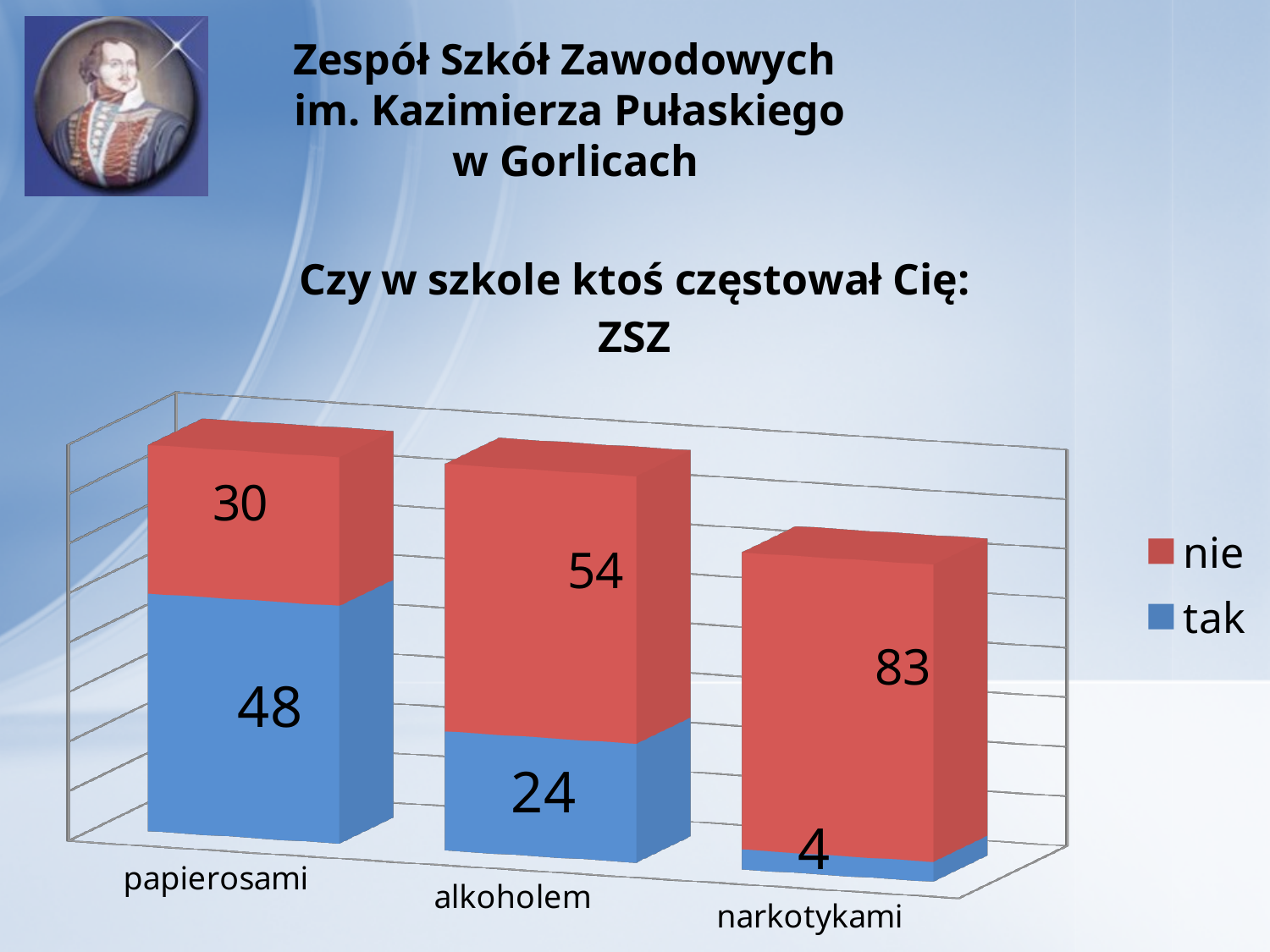
What kind of chart is shown on the slide? stacked bar chart How many series does the legend list? 2 Which is larger: the "tak" value for alkoholem or the "nie" value for alkoholem? nie Which category has the highest "tak" value? papierosami What is the value for "tak" for narkotykami? 4 What is the value for "nie" for alkoholem? 54 What is the value for "nie" for narkotykami? 83 Which category has the lowest "nie" value? papierosami What is the total of the stacked bar for papierosami? 78 How many categories are shown on the x axis? 3 What is the difference between the "nie" value for narkotykami and the "nie" value for alkoholem? 29 What is the value for "tak" for papierosami? 48